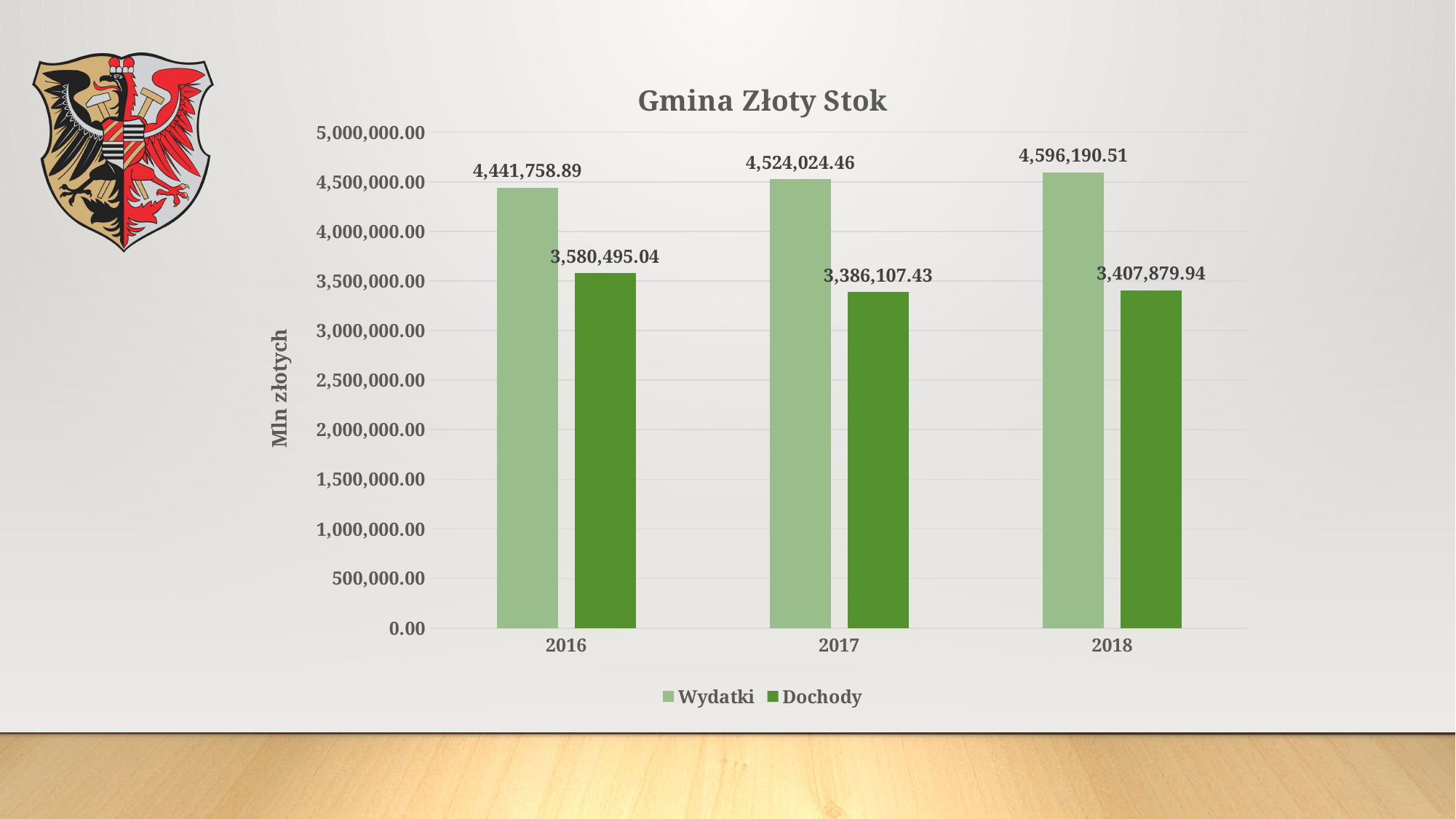
What is the value of Wydatki for 2017? 4,524,024.46 Which is larger in 2018, Wydatki or Dochody? Wydatki What is the difference between Wydatki and Dochody in 2016? 861,263.85 How many years are shown on the x axis? 3 Is the value of Dochody for 2017 greater or less than 3,500,000.00? less Do the Wydatki values rise or fall from 2016 to 2018? rise What is the value of Dochody for 2016? 3,580,495.04 How many series does the legend list? 2 By how much did Wydatki increase from 2016 to 2018? 154,431.62 In which year is Wydatki the highest? 2018 What is the value of Dochody for 2018? 3,407,879.94 In which year is Dochody the lowest? 2017